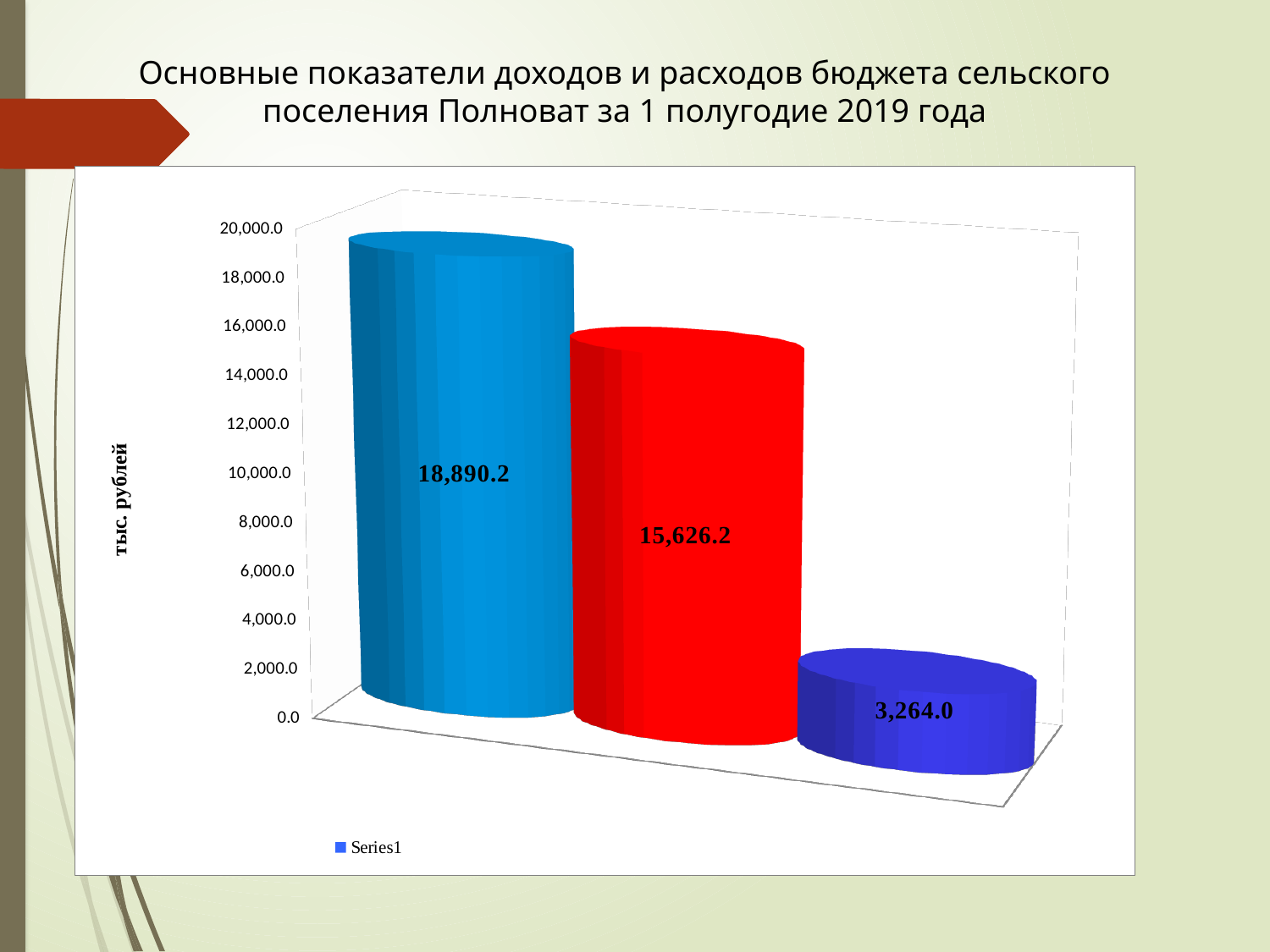
Which bar has the lowest value: the left, middle or right one? the right one What is the difference between the values of the left bar and the middle bar? 3,264.0 What kind of chart is shown on the slide? bar chart What is the value shown on the rightmost (dark blue) bar? 3,264.0 Which bar has the highest value: the left, middle or right one? the left one How many bars are plotted in the chart? 3 What is the difference between the values of the middle bar and the right bar? 12,362.2 What is the value shown on the leftmost (light blue) bar? 18,890.2 Which is larger, the value of the red bar or the value of the dark blue bar? the red bar Is the value of the middle bar greater or less than 16,000.0? less What is the label on the vertical axis of the chart? тыс. рублей What is the value shown on the middle (red) bar? 15,626.2